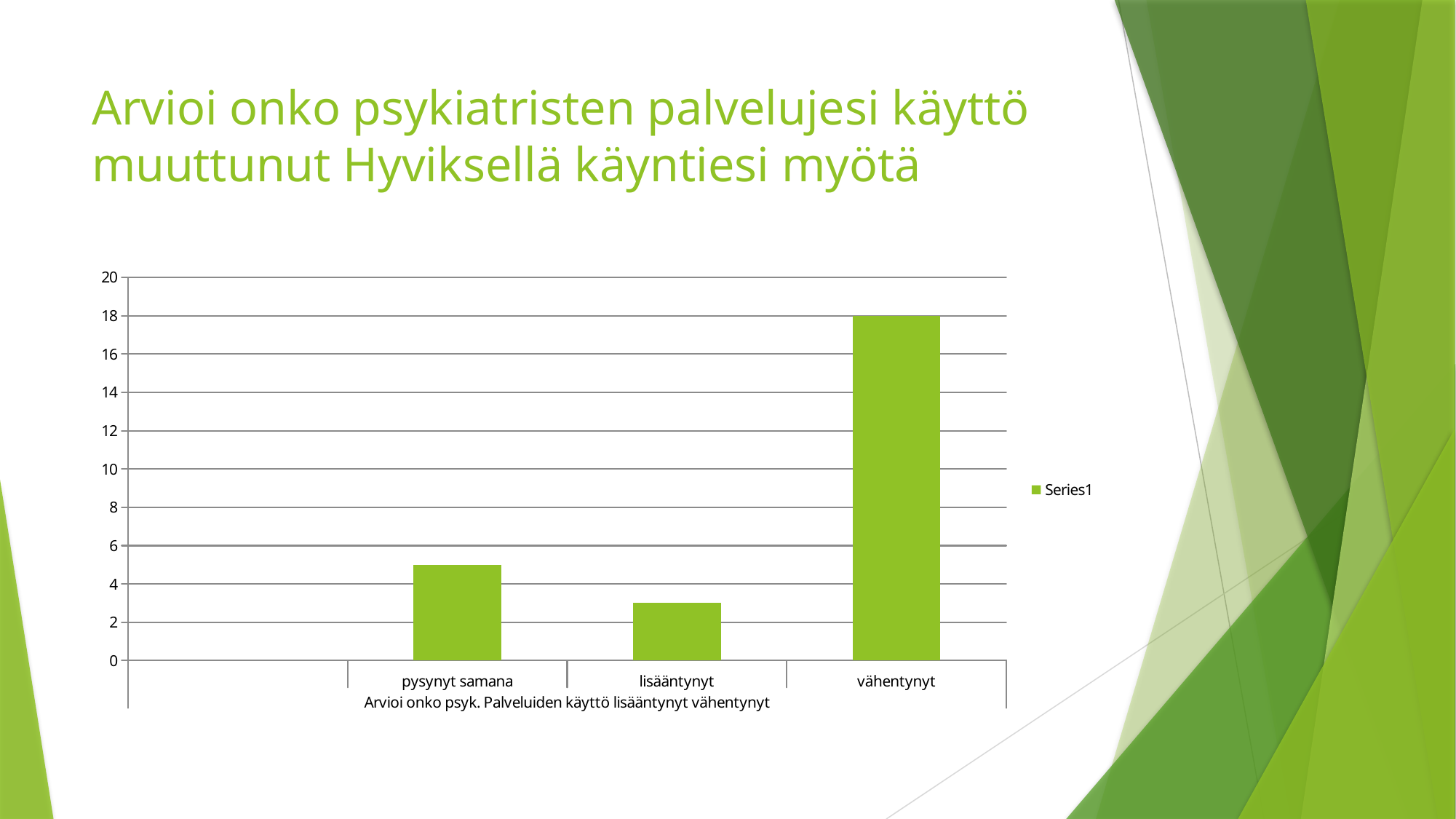
What kind of chart is shown on the slide? bar chart Which is larger, the value for pysynyt samana or the value for lisääntynyt? pysynyt samana Which category has the lowest value? lisääntynyt What is the value for vähentynyt? 18 What is the name of the series shown in the chart legend? Series1 Is the value for lisääntynyt greater or less than 4? less How many series does the chart legend list? 1 What is the title of the x axis of the chart? Arvioi onko psyk. Palveluiden käyttö lisääntynyt vähentynyt How many categories are shown on the x axis of the chart? 3 Is the value for pysynyt samana greater or less than 4? greater Is the value for pysynyt samana greater or less than 6? less Which category has the highest value? vähentynyt